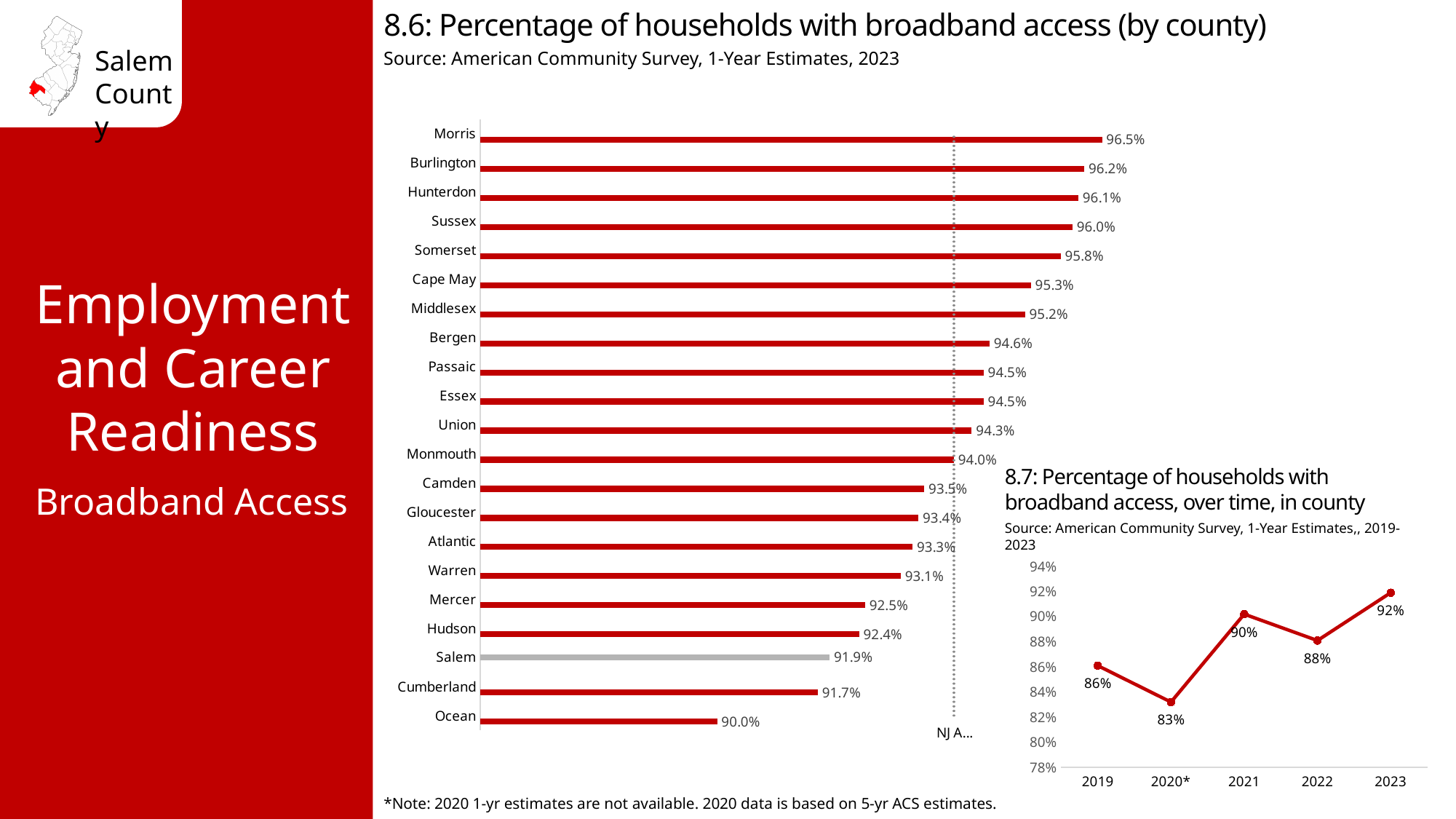
In chart 8.7, which year has the highest value? 2023 In chart 8.6, what is the difference between the values for Morris and Ocean? 6.5 percentage points In chart 8.7, what was the percentage of households with broadband access in 2020? 83% In chart 8.7, how many data points are plotted? 5 In chart 8.6, which county has the lowest percentage of households with broadband access? Ocean What kind of chart is chart 8.6? Bar chart In chart 8.6, which county has the highest percentage of households with broadband access? Morris In chart 8.6, what is the value for Cumberland? 91.7% In chart 8.6, how many counties are shown? 21 In chart 8.6, which county has a higher value, Camden or Hudson? Camden In chart 8.7, what is the difference between the 2023 and 2019 values? 6 percentage points In chart 8.6, what is the percentage of households with broadband access in Salem County? 91.9%